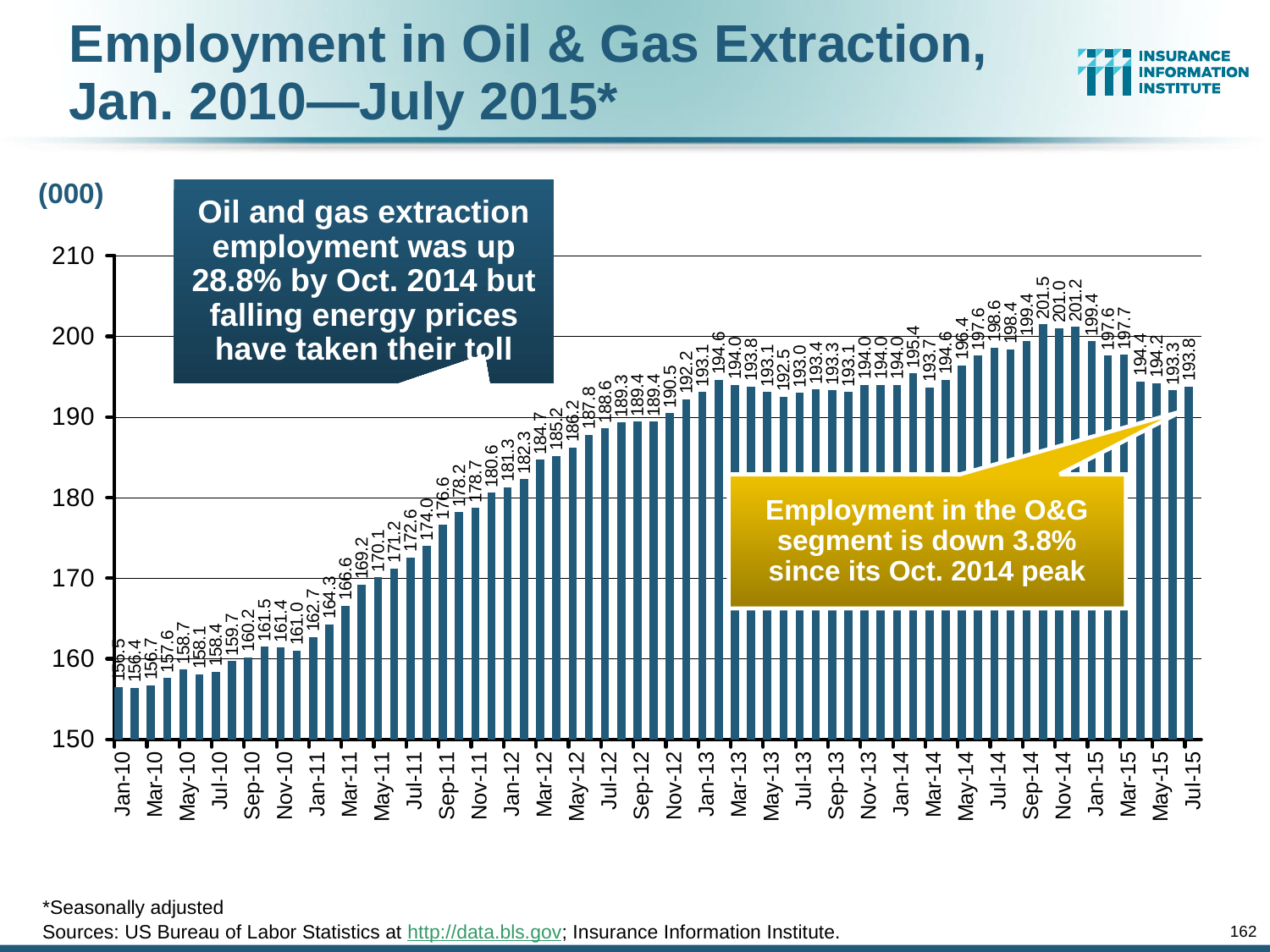
What type of chart is shown on the slide? Bar chart Which is larger, the value for Jan-15 or the value for Jul-15? Jan-15 Which month has the highest employment value in the chart? Oct. 2014 (201.5) What is the employment value for Jan-15? 199.4 What unit is indicated for the y-axis values? (000) What is the employment value for Jan-10? 156.5 Do the values generally rise or fall from Jan-10 to Jan-14? rise What is the employment value for Jan-12? 181.3 Is the value for Jul-11 greater or less than 170? greater What is the difference between the Jul-15 value and the Jan-10 value? 37.3 What is the employment value for Jul-15? 193.8 According to the callout, by what percentage is O&G employment down since its Oct. 2014 peak? 3.8%